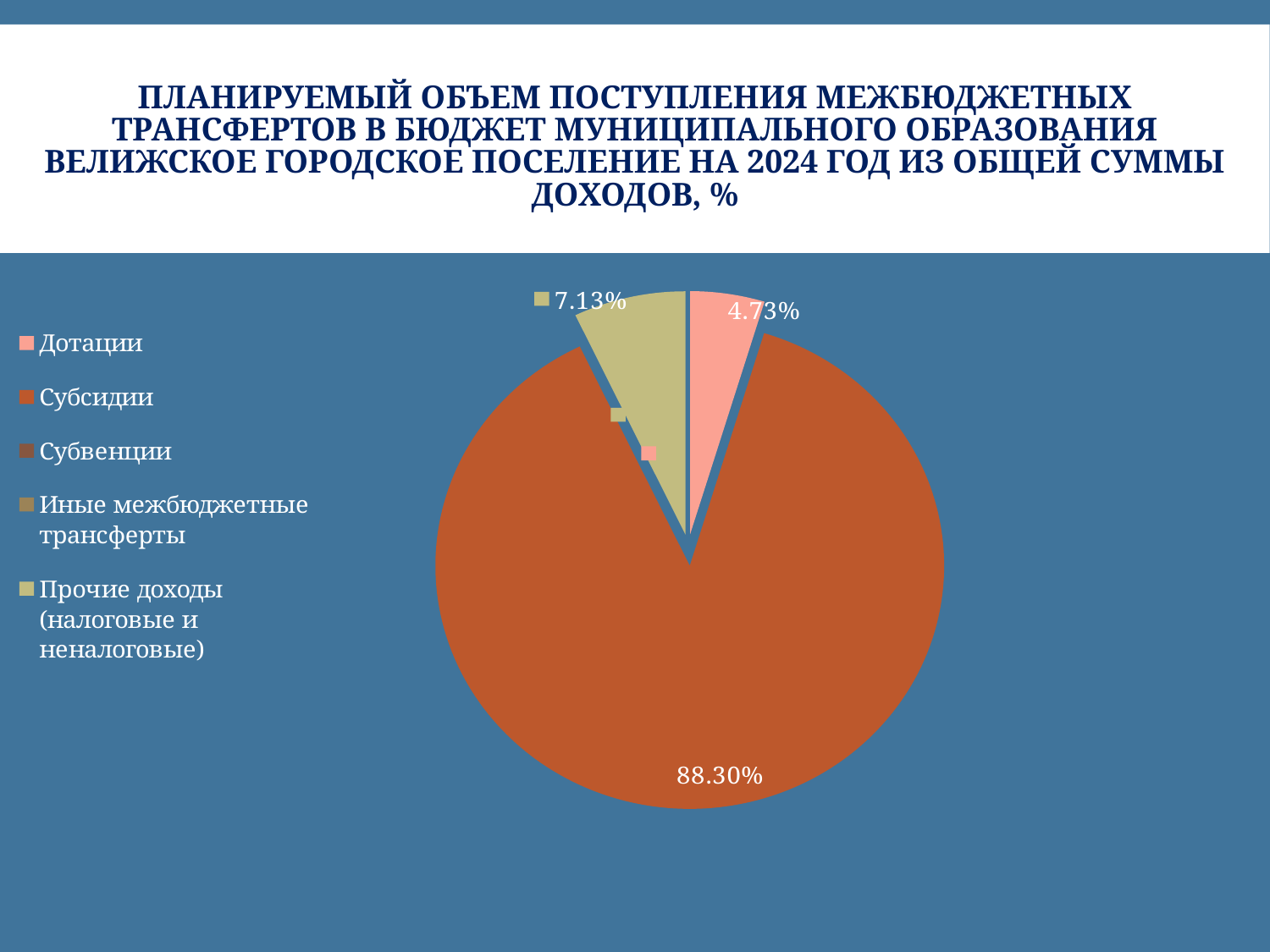
Which category has the largest share of the pie? Субсидии Which category is labelled 4.73% on the pie? Дотации What percentage is shown for Субсидии? 88.30% Which year does the chart title refer to? 2024 What percentage is shown for Дотации? 4.73% Which is larger, the share for Дотации or the share for Прочие доходы (налоговые и неналоговые)? Прочие доходы (налоговые и неналоговые) What percentage is shown for Прочие доходы (налоговые и неналоговые)? 7.13% What is the difference between the share for Субсидии and the share for Дотации? 83.57% What type of chart is shown on the slide? Pie chart How many categories does the legend list? 5 Is the share for Субсидии greater or less than 50%? greater What is the difference between the share for Прочие доходы (налоговые и неналоговые) and the share for Дотации? 2.40%